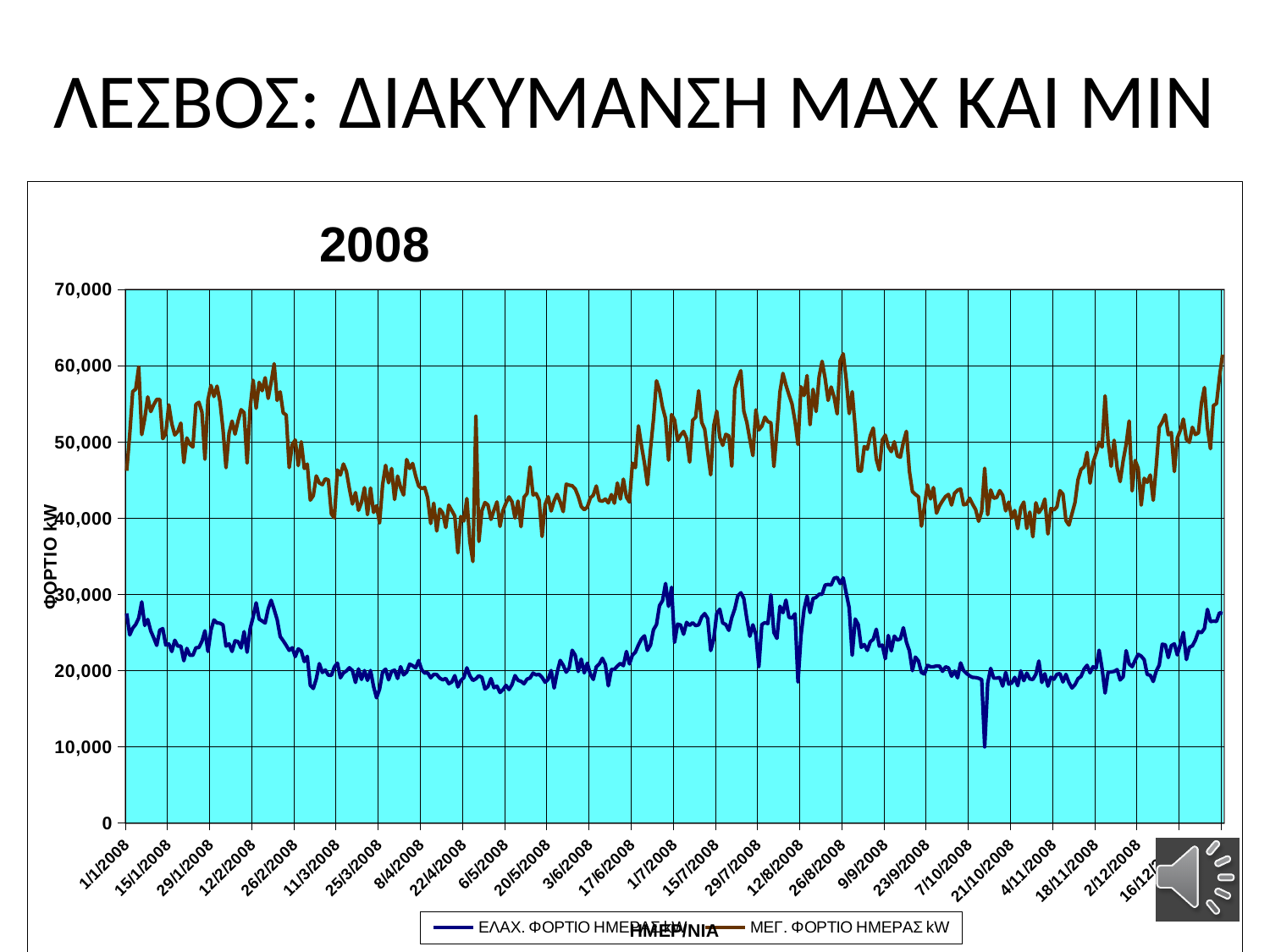
Does the ΕΛΑΧ. ΦΟΡΤΙΟ ΗΜΕΡΑΣ kW line generally rise or fall from 1/1/2008 to 22/4/2008? fall What is the title printed above the chart? 2008 Is the value of ΜΕΓ. ΦΟΡΤΙΟ ΗΜΕΡΑΣ kW at 6/5/2008 greater or less than 50,000? less Is the value of ΕΛΑΧ. ΦΟΡΤΙΟ ΗΜΕΡΑΣ kW at 22/4/2008 greater or less than 30,000? less Is the value of ΜΕΓ. ΦΟΡΤΙΟ ΗΜΕΡΑΣ kW around 26/8/2008 greater or less than 50,000? greater Which series reaches the highest value on the chart? ΜΕΓ. ΦΟΡΤΙΟ ΗΜΕΡΑΣ kW What is the label of the vertical axis? ΦΟΡΤΙΟ kW What kind of chart is shown on the slide? line chart How many series does the legend list? 2 At 1/7/2008, which series has the higher value, ΕΛΑΧ. ΦΟΡΤΙΟ ΗΜΕΡΑΣ kW or ΜΕΓ. ΦΟΡΤΙΟ ΗΜΕΡΑΣ kW? ΜΕΓ. ΦΟΡΤΙΟ ΗΜΕΡΑΣ kW